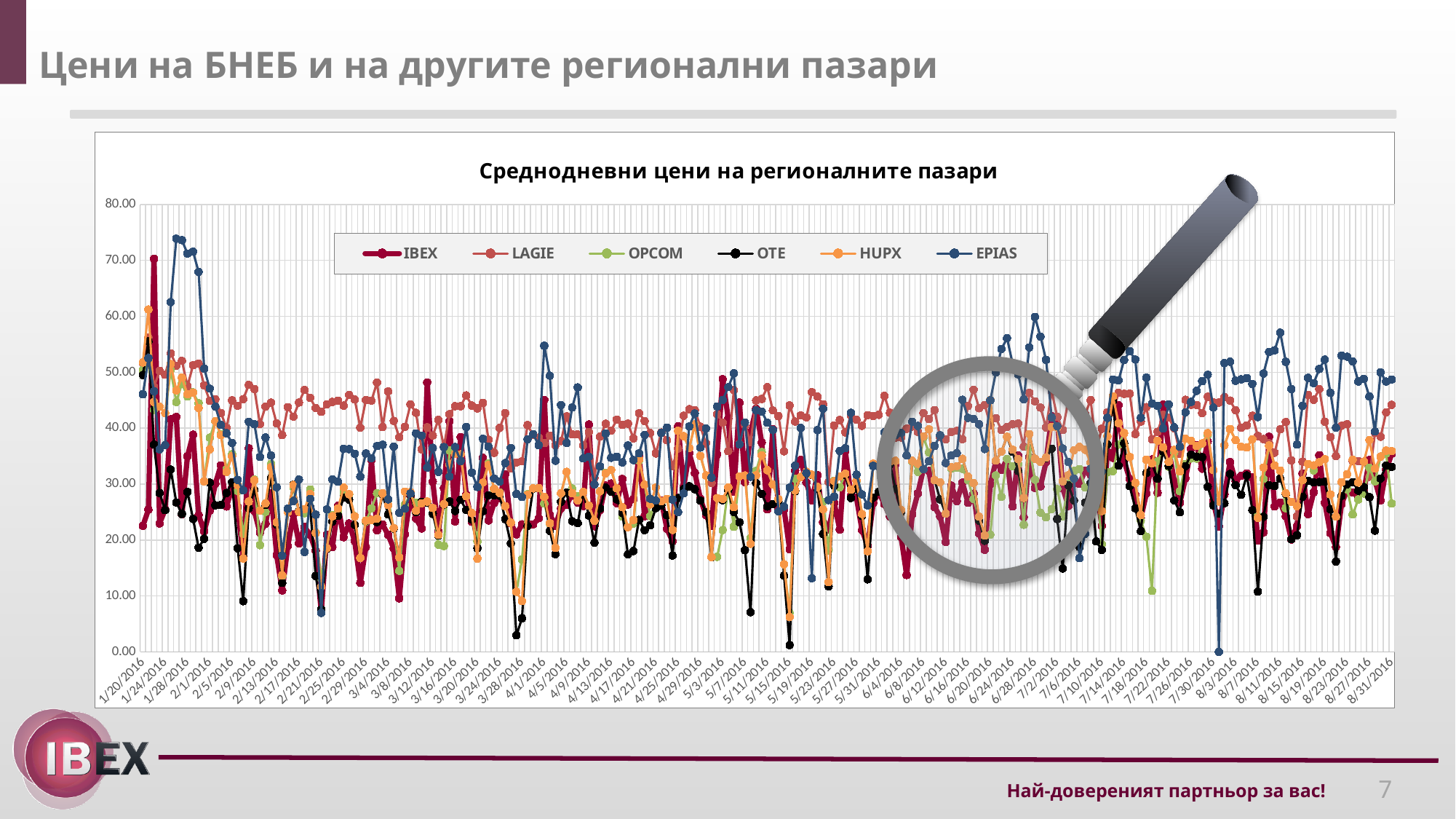
Is the highest LAGIE value on the chart greater or less than 60.00? less In August 2016, which series generally has the highest values on the chart, EPIAS or OTE? EPIAS What is the title of the chart? Среднодневни цени на регионалните пазари What kind of chart is shown on the slide? line chart How many series does the chart legend list? 6 Is the highest EPIAS value on the chart greater or less than 70.00? greater What is the last date label on the horizontal axis of the chart? 8/31/2016 Is the lowest EPIAS value on the chart greater or less than 10.00? less What is the first date label on the horizontal axis of the chart? 1/20/2016 Which series is drawn in green in the chart? OPCOM What is the highest value shown on the vertical axis of the chart? 80.00